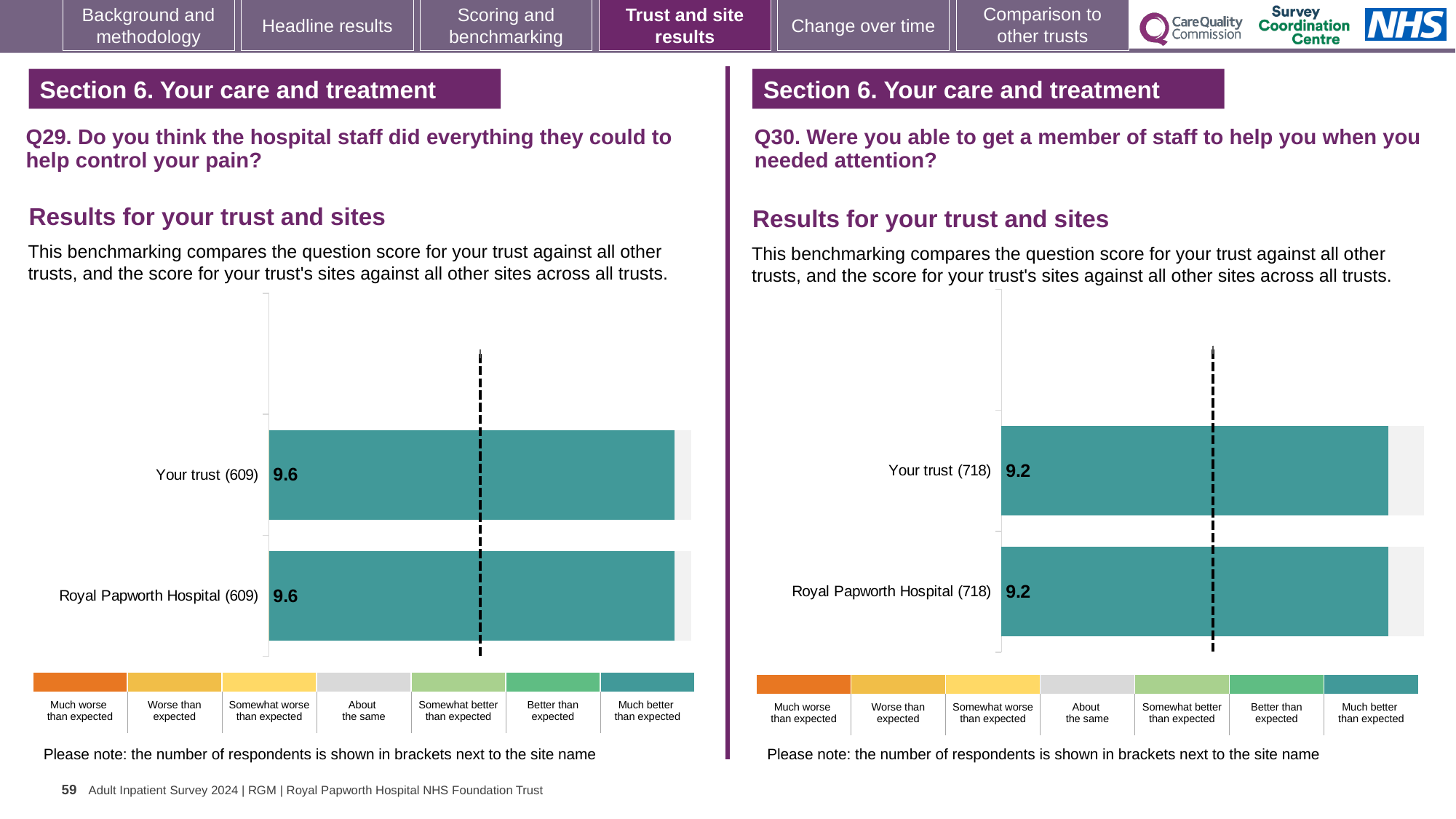
In the Q30 chart on the right, what is the difference between the score for Your trust and the score for Royal Papworth Hospital? 0 In the Q29 chart on the left, what is the score for Your trust (609)? 9.6 In the Q29 chart on the left, what is the difference between the score for Your trust and the score for Royal Papworth Hospital? 0 In the Q29 chart on the left, what is the score for Royal Papworth Hospital (609)? 9.6 In the Q30 chart on the right, which benchmark category does the colour of the bars correspond to in the legend? Much better than expected How many bars are plotted in the Q29 chart on the left? 2 What kind of chart is used in the Q30 chart on the right? Bar chart In the Q30 chart on the right, what is the score for Royal Papworth Hospital (718)? 9.2 In the Q29 chart on the left, how many respondents are shown in brackets next to Royal Papworth Hospital? 609 Which is larger: the Your trust score in the Q29 chart on the left or the Your trust score in the Q30 chart on the right? Q29 chart (9.6) How many bars are plotted in the Q30 chart on the right? 2 In the Q30 chart on the right, what is the score for Your trust (718)? 9.2